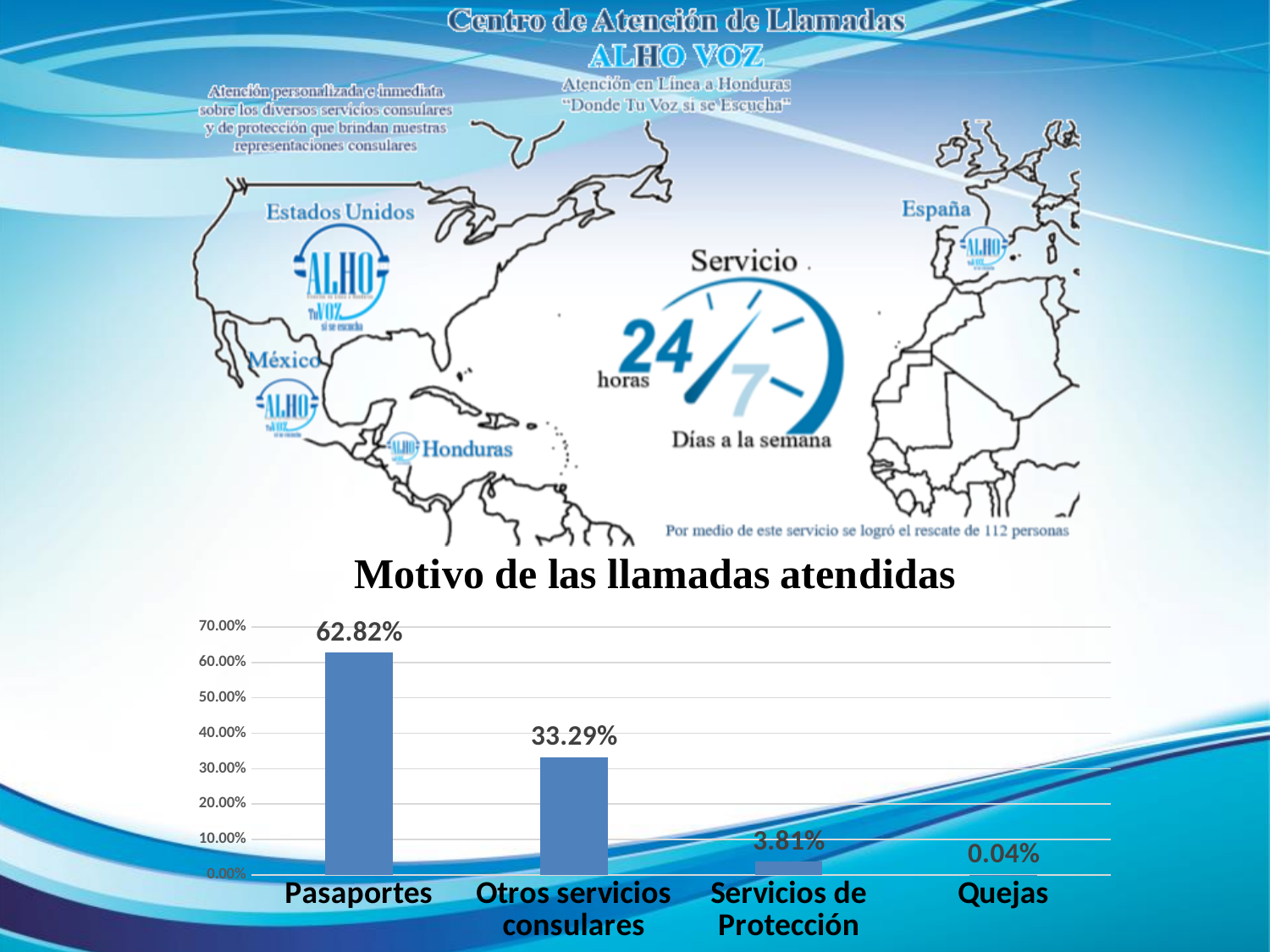
Which is larger, the value for Servicios de Protección or the value for Quejas? Servicios de Protección What is the title of the chart? Motivo de las llamadas atendidas Is the value for Pasaportes greater or less than 60.00%? greater What kind of chart is shown on the slide? Bar chart What is the difference between the values for Pasaportes and Otros servicios consulares? 29.53% Which category has the lowest value? Quejas What is the value for Servicios de Protección? 3.81% What is the value for Quejas? 0.04% What is the value for Pasaportes in the chart 'Motivo de las llamadas atendidas'? 62.82% Which category has the highest value? Pasaportes How many categories are shown in the chart? 4 What is the value for Otros servicios consulares? 33.29%